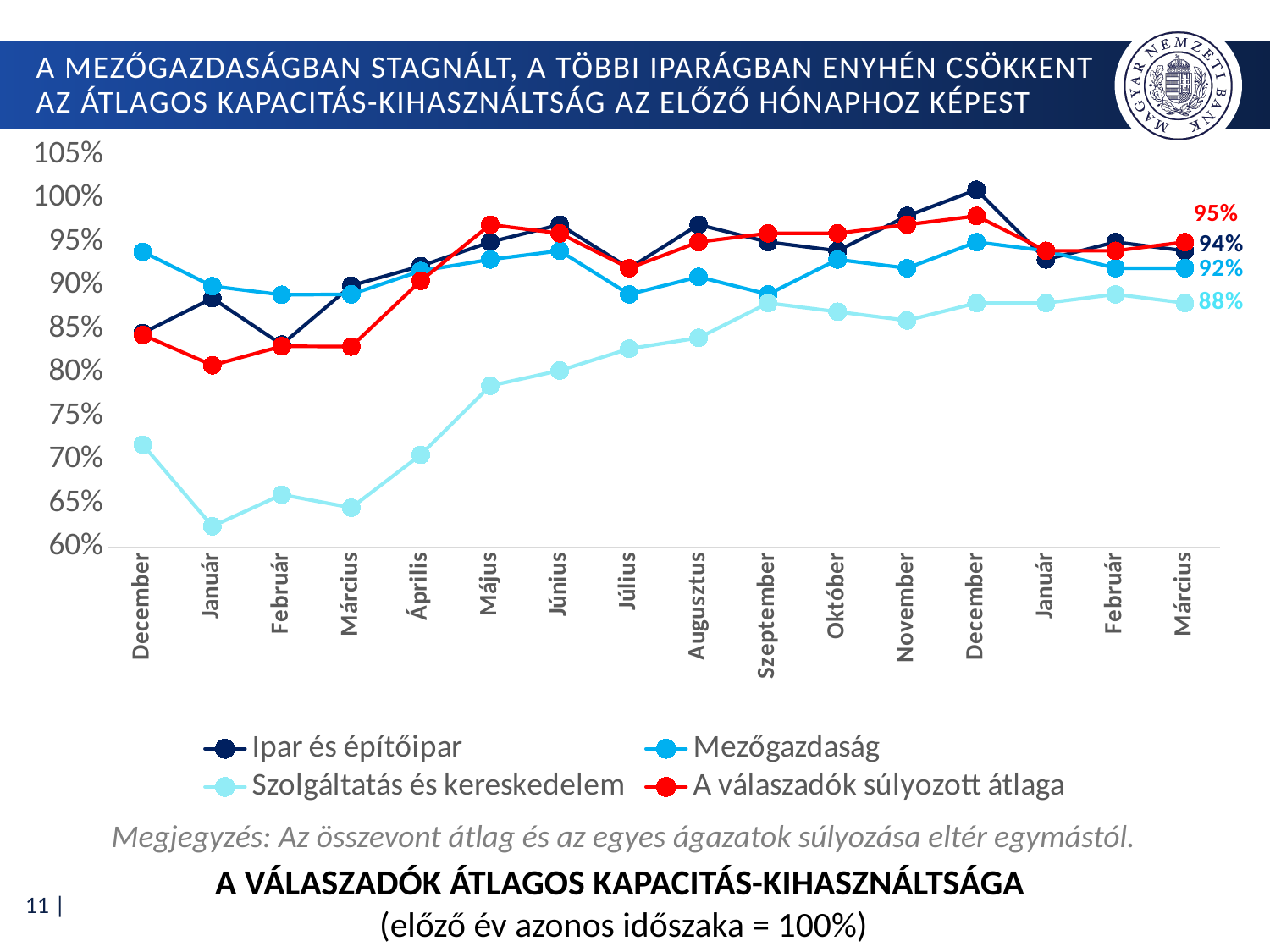
How many months are shown on the x axis? 16 How many series does the legend list? 4 What is the value for A válaszadók súlyozott átlaga at the final Március point? 95% Which series has the lowest value in the first Január? Szolgáltatás és kereskedelem What kind of chart is shown on the slide? line chart What is the value for Mezőgazdaság at the final Március point? 92% Which series has the highest value at the final Március point? A válaszadók súlyozott átlaga At the final Március point, what is the difference between Ipar és építőipar and Szolgáltatás és kereskedelem? 6 percentage points What is the value for Szolgáltatás és kereskedelem at the final Március point? 88% In the first December, which is higher: Mezőgazdaság or Ipar és építőipar? Mezőgazdaság Is the value for Szolgáltatás és kereskedelem in the first Január greater or less than 65%? less What is the value for Ipar és építőipar at the final Március point? 94%